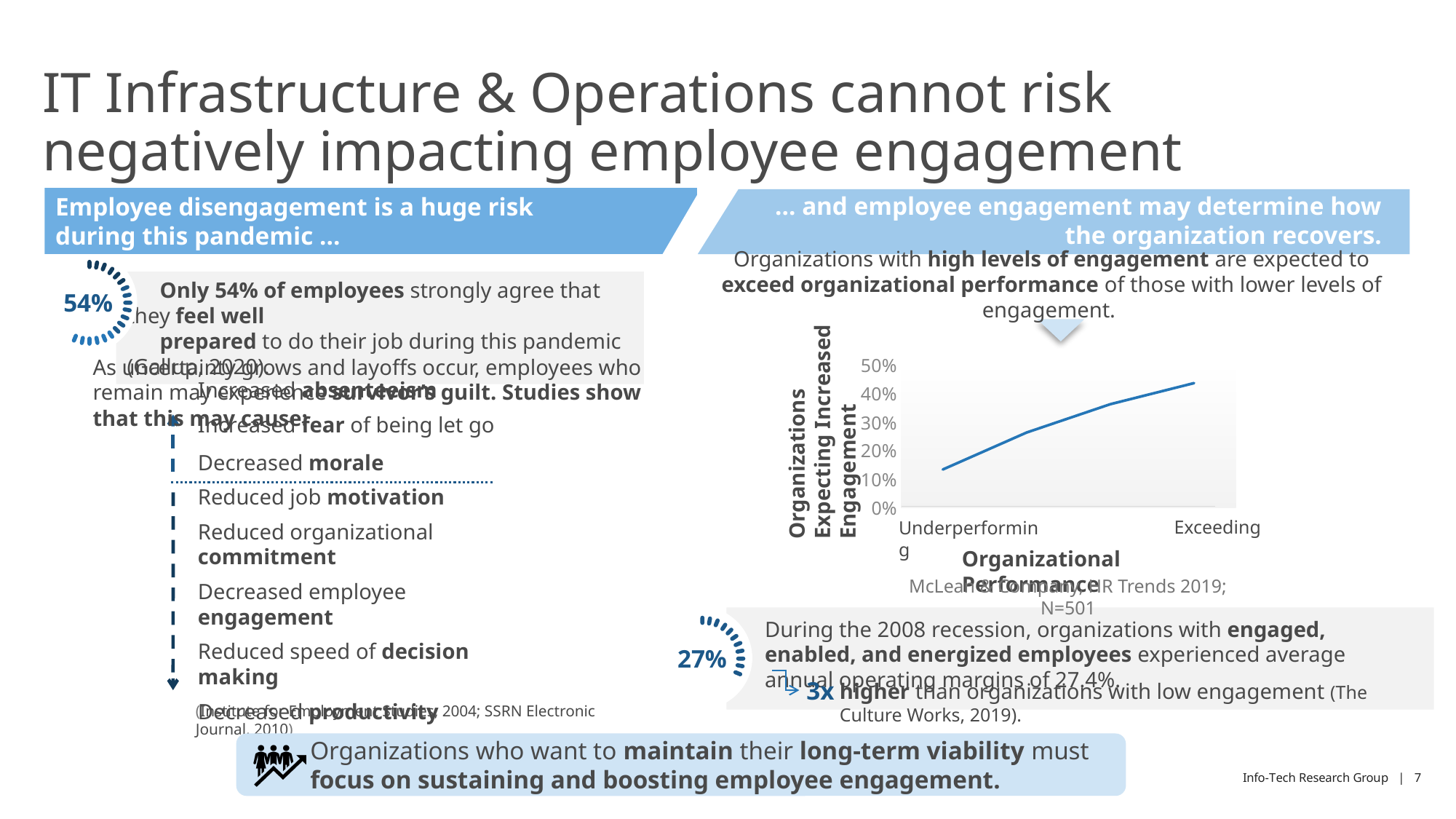
Is the value for Underperforming organizations greater or less than 20%? less Which category on the x axis has the highest value in the chart? Exceeding What is the label of the chart's x axis? Organizational Performance What is the label of the chart's y axis? Organizations Expecting Increased Engagement What kind of chart is shown on the slide? line chart Which has the higher value in the chart, Underperforming or Exceeding? Exceeding Is the value for Underperforming organizations greater or less than 10%? greater Which category on the x axis has the lowest value in the chart? Underperforming Is the value for Exceeding organizations greater or less than 40%? greater Do the values in the chart rise or fall as organizational performance moves from Underperforming to Exceeding? rise